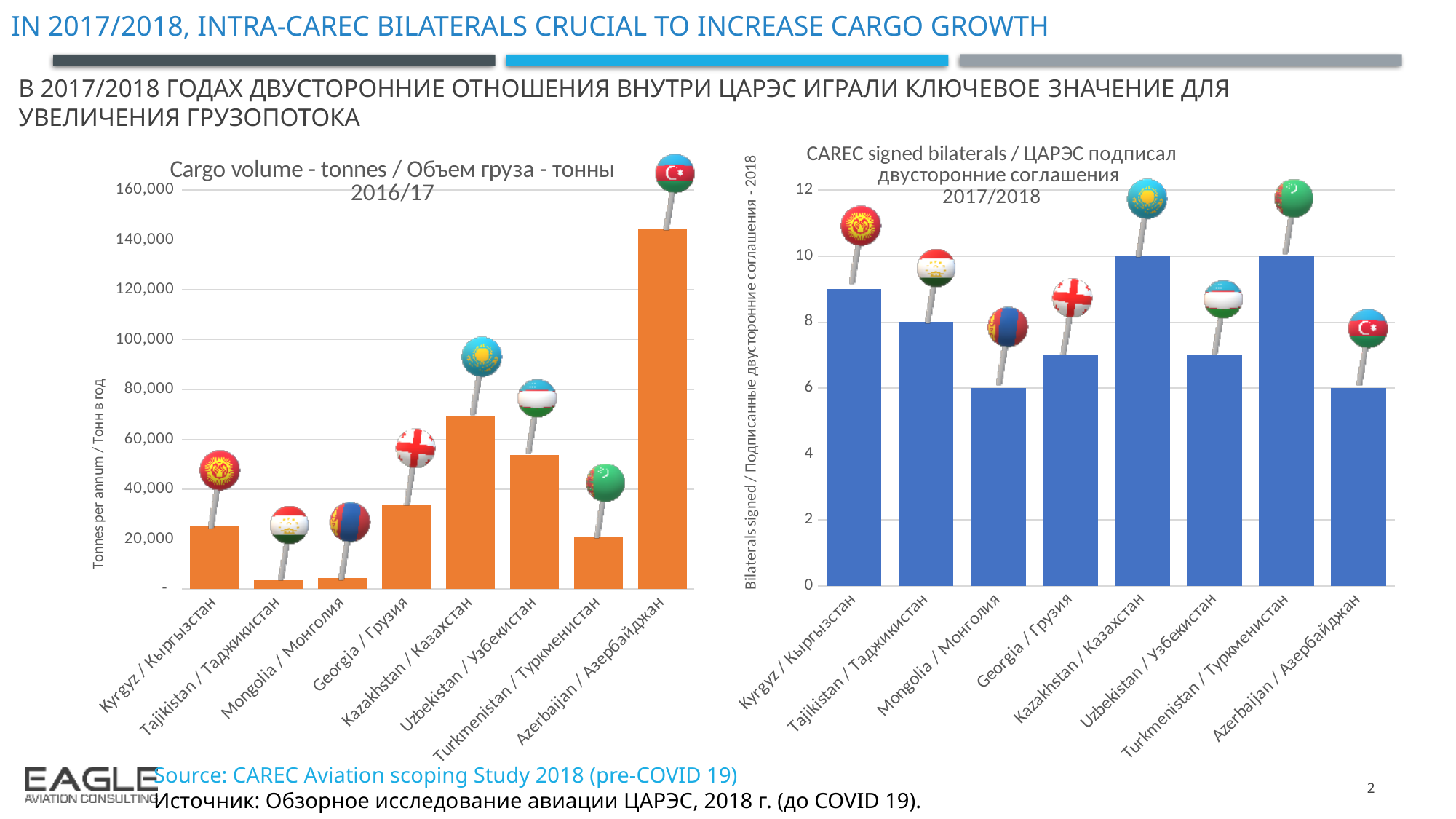
On the right chart (CAREC signed bilaterals 2017/2018), how many bilaterals did Kazakhstan sign? 10 On the left chart (Cargo volume - tonnes 2016/17), is the value for Tajikistan greater or less than 20,000? less On the left chart (Cargo volume - tonnes 2016/17), which country has the highest cargo volume? Azerbaijan / Азербайджан On the left chart (Cargo volume - tonnes 2016/17), which is larger, the value for Uzbekistan or the value for Georgia? Uzbekistan / Узбекистан What type of chart is the right chart (CAREC signed bilaterals 2017/2018)? bar chart On the right chart (CAREC signed bilaterals 2017/2018), what is the difference between the values for Kazakhstan and Mongolia? 4 On the right chart (CAREC signed bilaterals 2017/2018), which is larger, the value for Tajikistan or the value for Azerbaijan? Tajikistan / Таджикистан On the left chart (Cargo volume - tonnes 2016/17), is the value for Kazakhstan greater or less than 60,000? greater On the left chart (Cargo volume - tonnes 2016/17), is the value for Azerbaijan greater or less than 120,000? greater On the right chart (CAREC signed bilaterals 2017/2018), how many bilaterals did Tajikistan sign? 8 How many countries are shown on the left chart (Cargo volume - tonnes 2016/17)? 8 On the right chart (CAREC signed bilaterals 2017/2018), how many bilaterals did Mongolia sign? 6